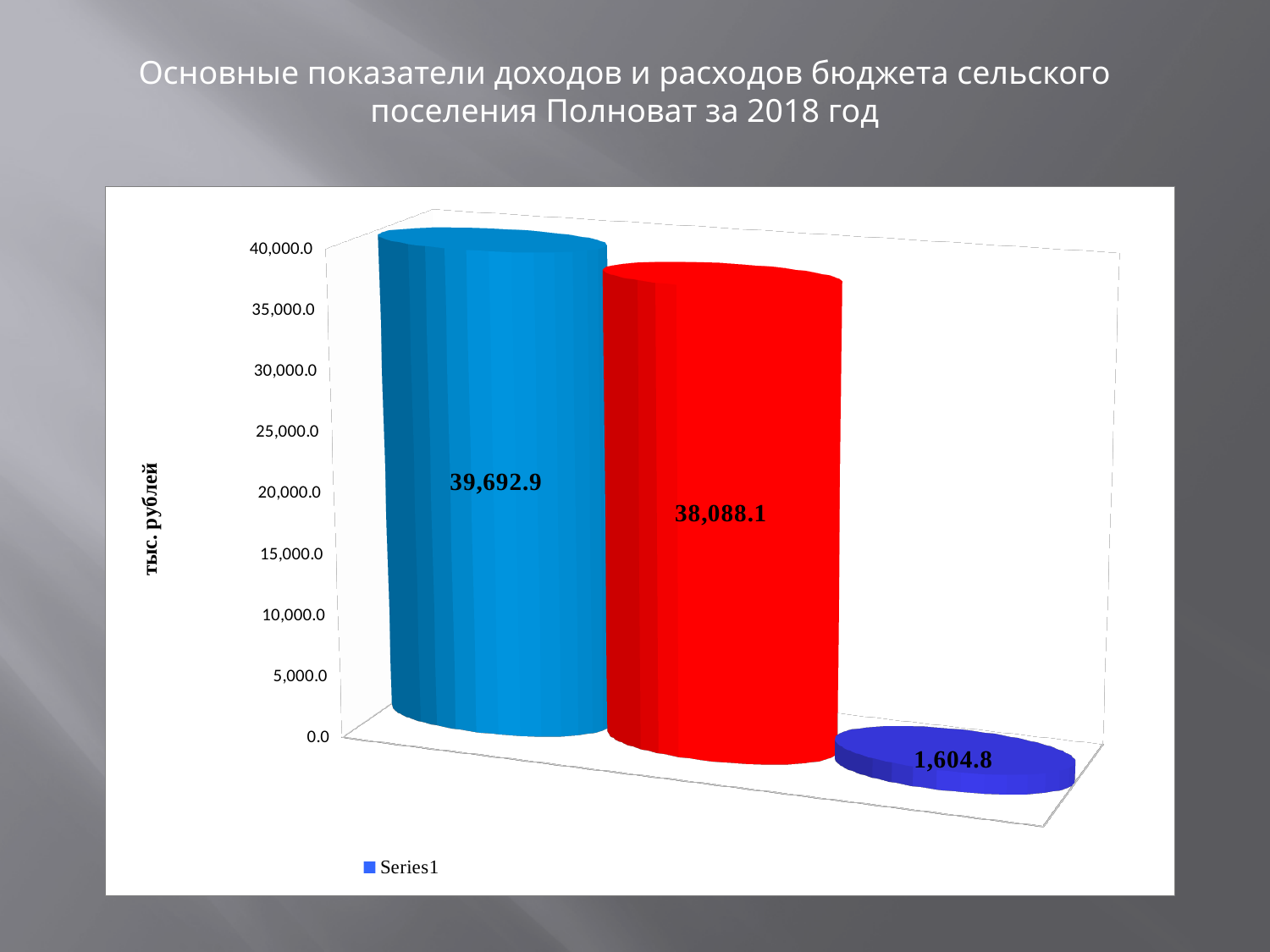
Which bar has the highest value? The light blue bar (first from the left), 39,692.9 How many series does the legend list? 1 What is the value shown on the light blue bar (the first bar from the left)? 39,692.9 Is the value of the red bar greater or less than 35,000.0? greater What is the value shown on the red bar (the middle bar)? 38,088.1 What is the difference between the value of the light blue bar and the value of the red bar? 1,604.8 How many bars are plotted in the chart? 3 What is the title of the vertical axis? тыс. рублей Which bar has the lowest value? The dark blue bar (rightmost), 1,604.8 What is the value shown on the dark blue bar (the rightmost bar)? 1,604.8 What kind of chart is shown on the slide? Bar chart Which is larger: the value of the red bar or the value of the dark blue bar? The red bar